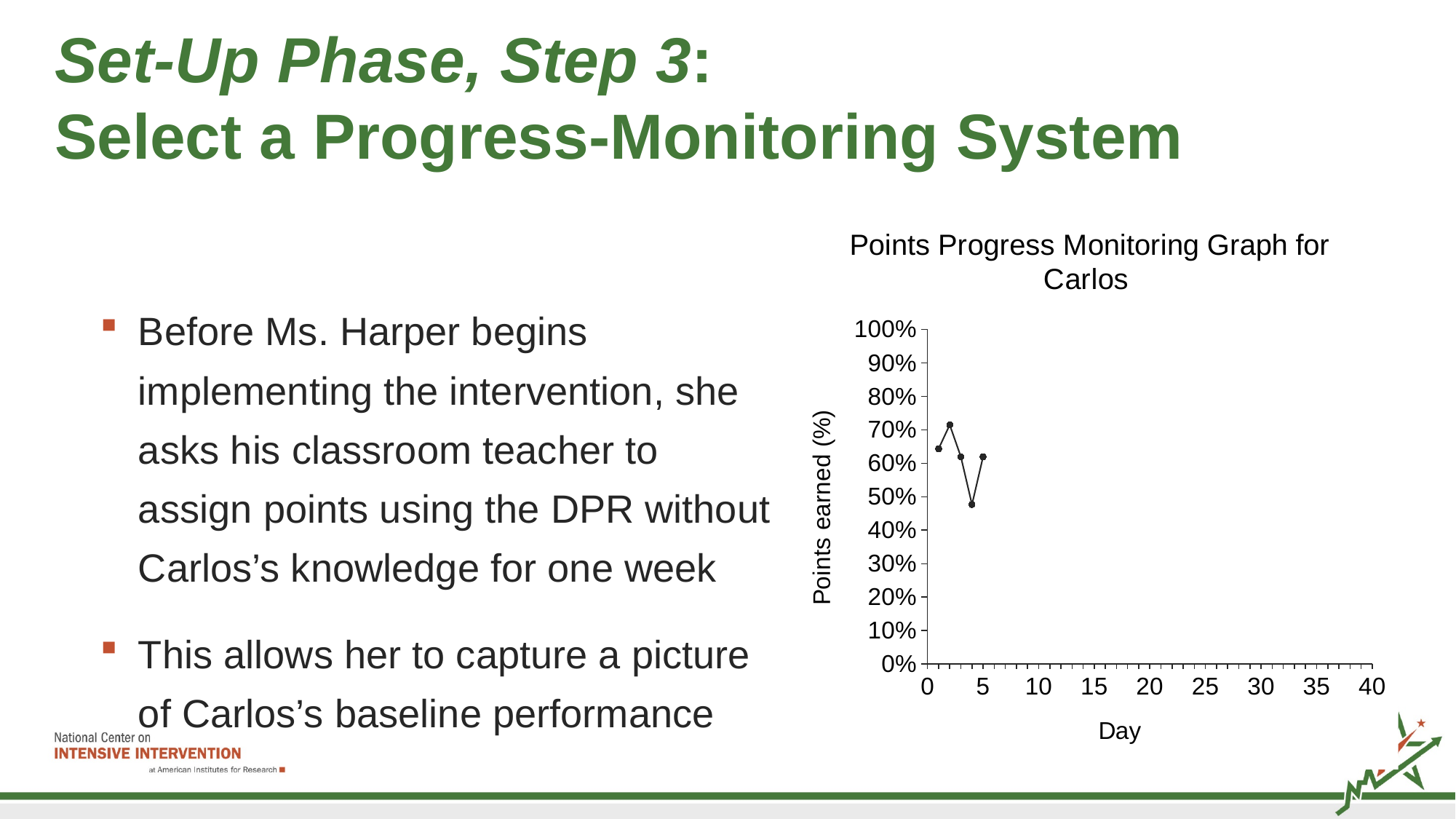
Is the value for Day 1 greater or less than 50%? greater What type of chart is shown on the slide? line chart Does the plotted value rise or fall from Day 2 to Day 4? fall Is the value for Day 4 greater or less than 60%? less What is the title of the chart? Points Progress Monitoring Graph for Carlos Is the value for Day 2 greater or less than 60%? greater On which day is the points earned value lowest? Day 4 How many data points are plotted on the chart? 5 Which is larger, the value for Day 2 or the value for Day 4? Day 2 What is the label of the y axis of the chart? Points earned (%) On which day is the points earned value highest? Day 2